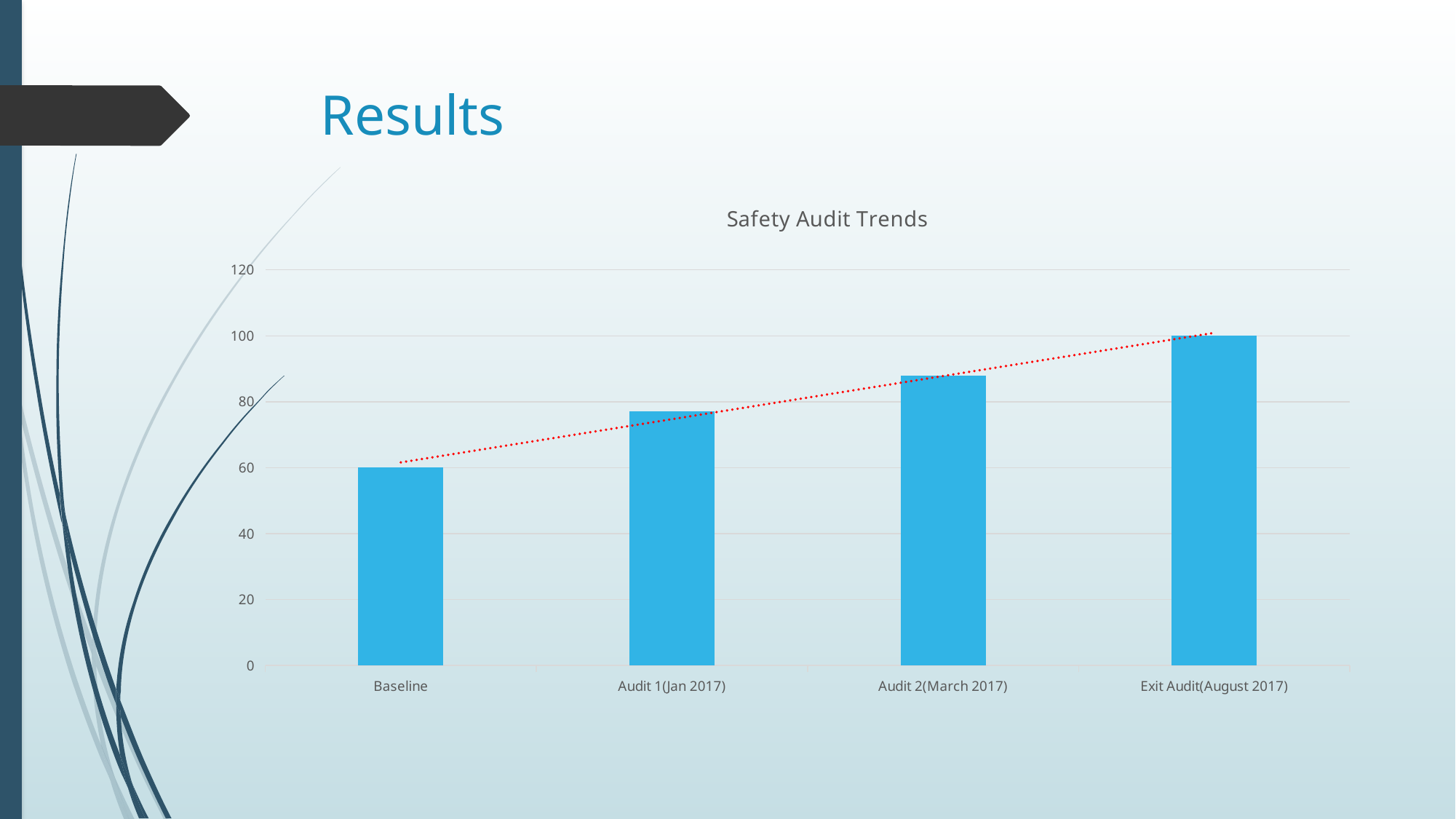
What is the difference between the Exit Audit(August 2017) value and the Baseline value? 40 Is the value for Audit 2(March 2017) greater or less than 80? greater How many categories are shown on the x axis of the Safety Audit Trends chart? 4 Is the value for Audit 1(Jan 2017) greater or less than 80? less Which is larger, the value for Audit 1(Jan 2017) or the value for Audit 2(March 2017)? Audit 2(March 2017) Do the values rise or fall from Baseline to Exit Audit(August 2017)? rise Which category has the lowest value in the Safety Audit Trends chart? Baseline What type of chart is shown on the slide? bar chart Which category has the highest value in the Safety Audit Trends chart? Exit Audit(August 2017) What is the value for Baseline in the Safety Audit Trends chart? 60 What is the title of the chart? Safety Audit Trends What is the value for Exit Audit(August 2017) in the Safety Audit Trends chart? 100